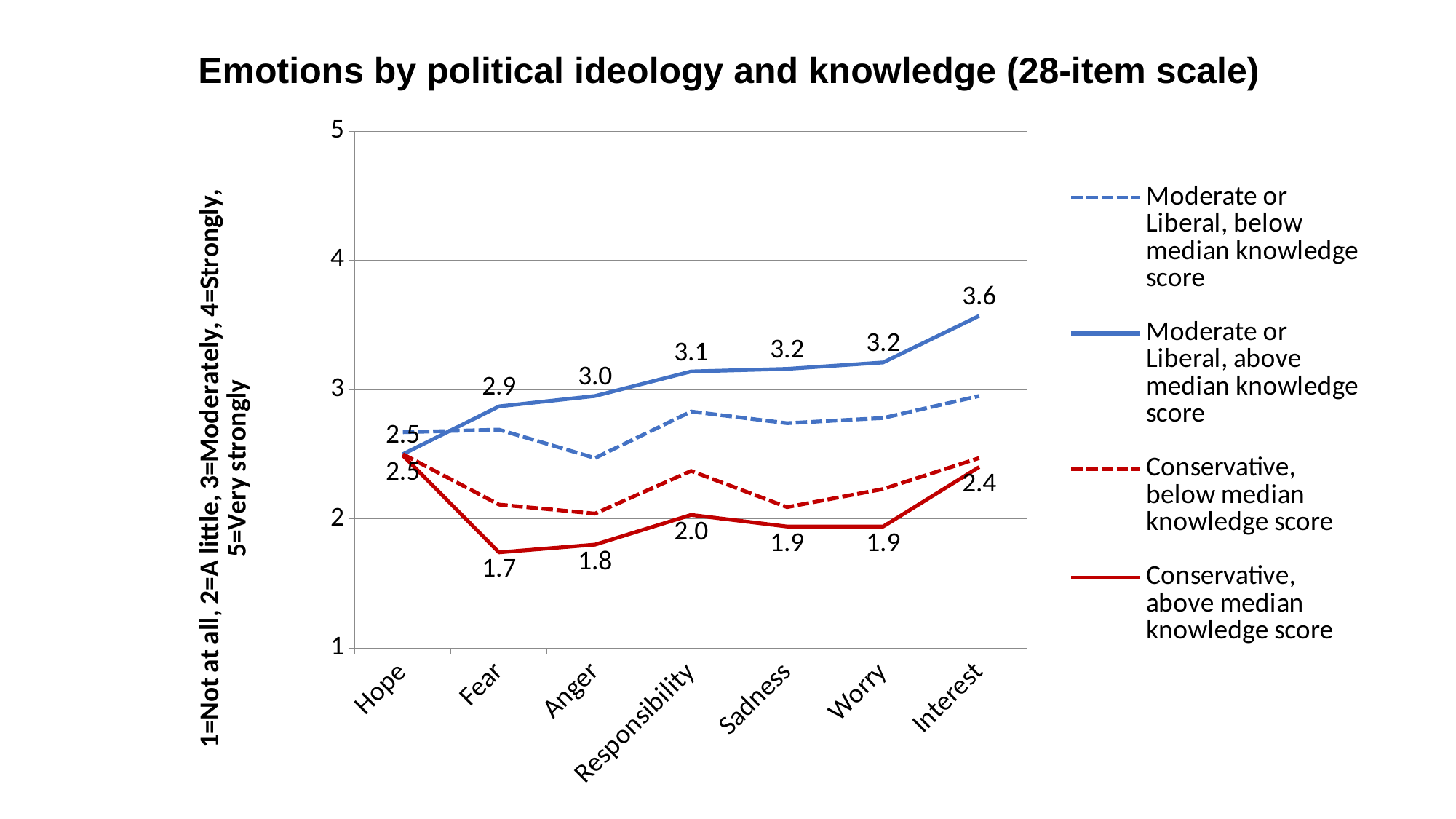
What is the value for Interest for the 'Moderate or Liberal, above median knowledge score' series? 3.6 Which emotion has the highest value for the 'Moderate or Liberal, above median knowledge score' series? Interest What is the title of the chart? Emotions by political ideology and knowledge (28-item scale) What is the value for Fear for the 'Conservative, above median knowledge score' series? 1.7 How many emotion categories are shown on the x axis? 7 What type of chart is shown on the slide? line chart What is the value for Responsibility for the 'Conservative, above median knowledge score' series? 2.0 What is the difference between the 'Moderate or Liberal, above median knowledge score' and 'Conservative, above median knowledge score' values for Interest? 1.2 How many series does the legend list? 4 For Anger, which is larger: the 'Moderate or Liberal, above median knowledge score' value or the 'Conservative, above median knowledge score' value? Moderate or Liberal, above median knowledge score Which emotion has the lowest value for the 'Conservative, above median knowledge score' series? Fear Is the value for Anger for the 'Conservative, below median knowledge score' series greater or less than 3? less